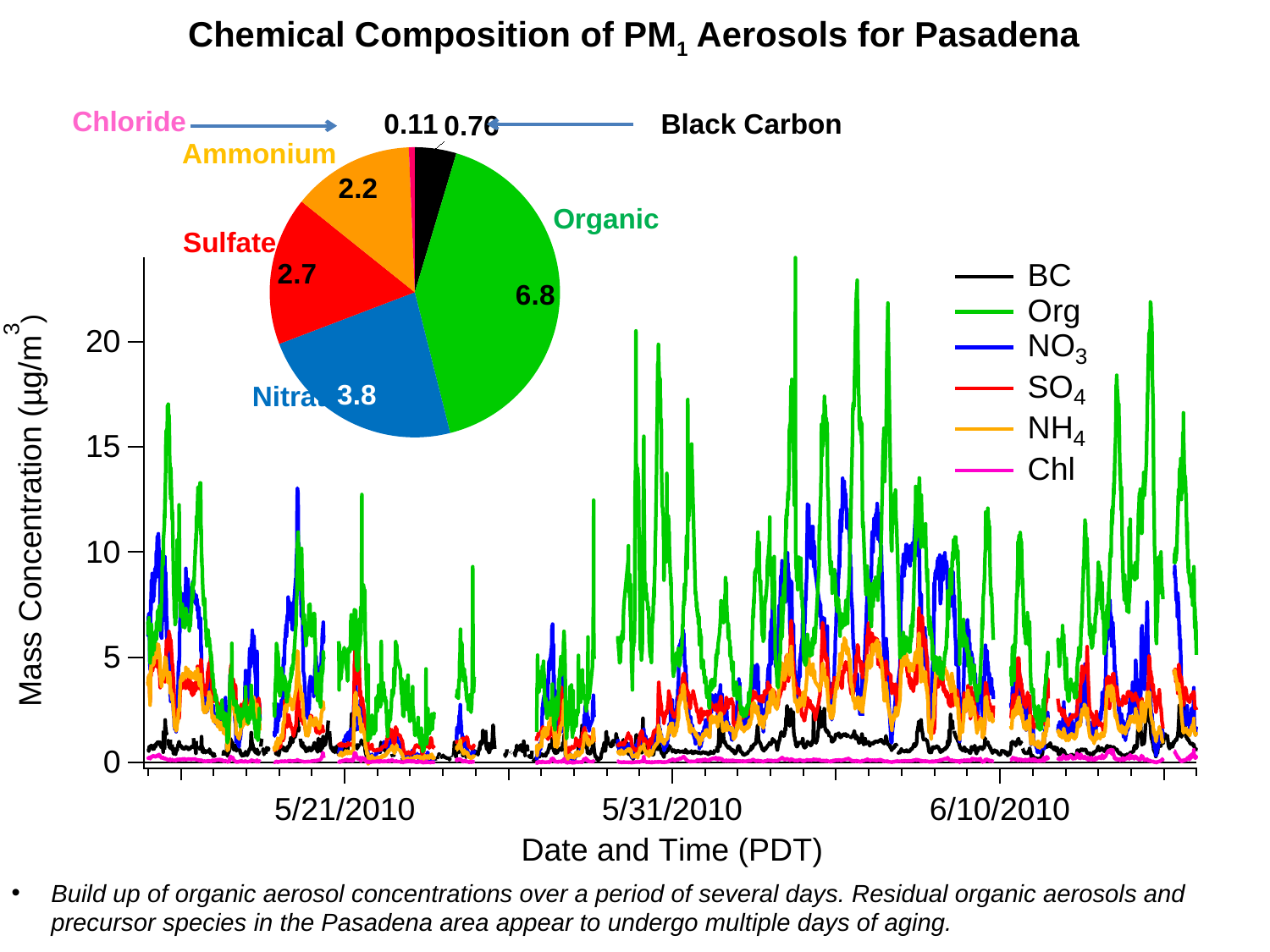
In the pie chart, what is the value shown for Black Carbon? 0.76 In the pie chart, what is the value shown for Nitrate? 3.8 In the pie chart, which component has the largest slice? Organic In the pie chart, what is the value shown for Sulfate? 2.7 In the pie chart, what is the value shown for Organic? 6.8 What kind of chart is the large chart plotting mass concentration against date and time? Line chart In the pie chart, what is the value shown for Chloride? 0.11 How many series does the legend of the time-series chart list? 6 In the pie chart, which component has the smallest slice? Chloride In the pie chart, what is the difference between the Organic value and the Nitrate value? 3.0 In the pie chart, which is larger, Sulfate or Ammonium? Sulfate In the pie chart, what is the value shown for Ammonium? 2.2